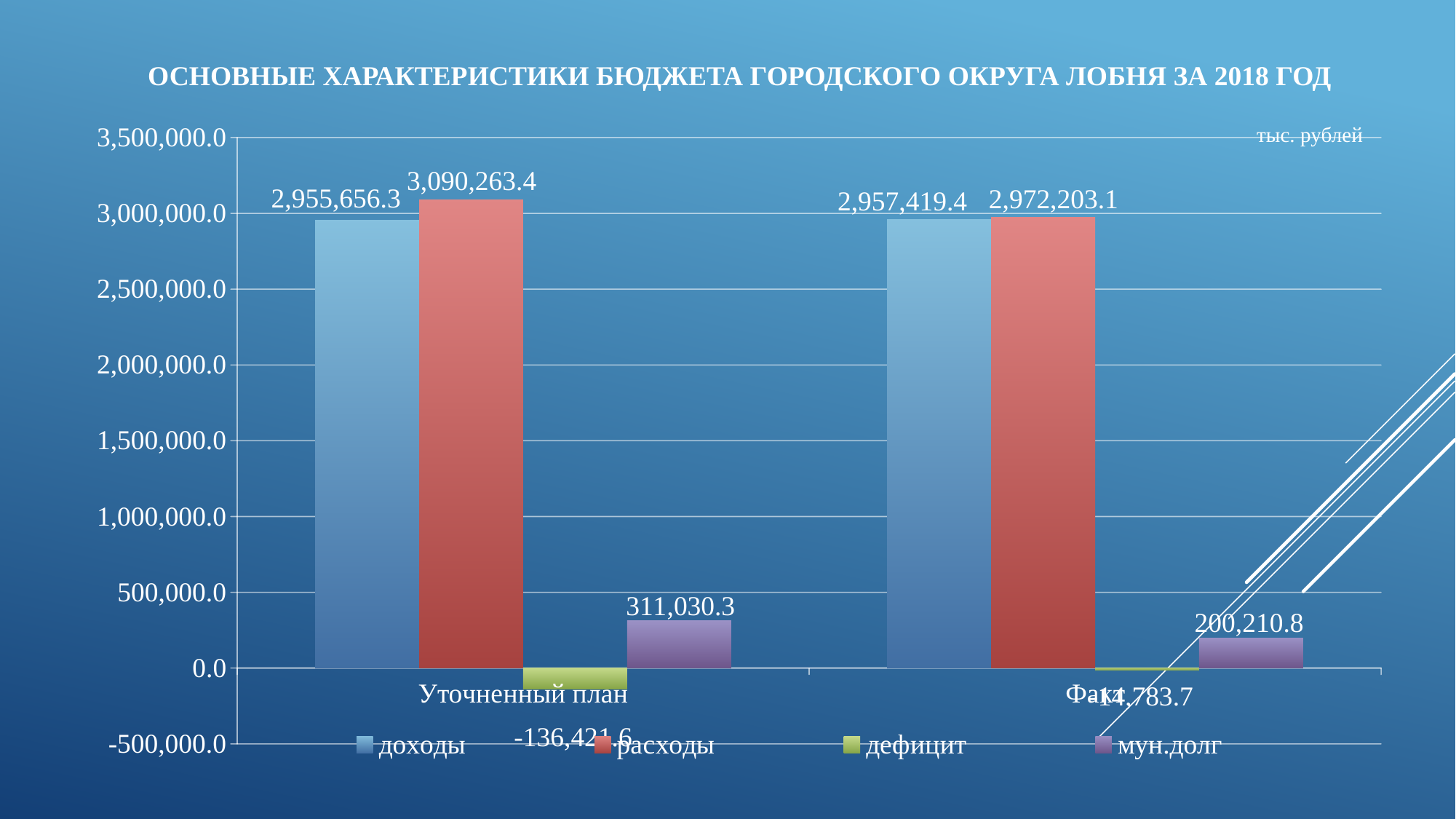
What is the difference between расходы and доходы for Уточненный план? 134,607.1 Which is larger: расходы for Уточненный план or расходы for Факт? расходы for Уточненный план What is the value of мун.долг for Уточненный план? 311,030.3 Is the value of мун.долг for Факт greater or less than 500,000.0? less What is the value of расходы for Факт? 2,972,203.1 What is the value of доходы for Уточненный план? 2,955,656.3 What is the value of дефицит for Уточненный план? -136,421.6 What is the difference between мун.долг for Уточненный план and мун.долг for Факт? 110,819.5 What unit is shown in the top right corner of the chart? тыс. рублей How many series does the legend list? 4 Which series has the highest bar in the Уточненный план category? расходы Which series has the lowest value in the Уточненный план category? дефицит